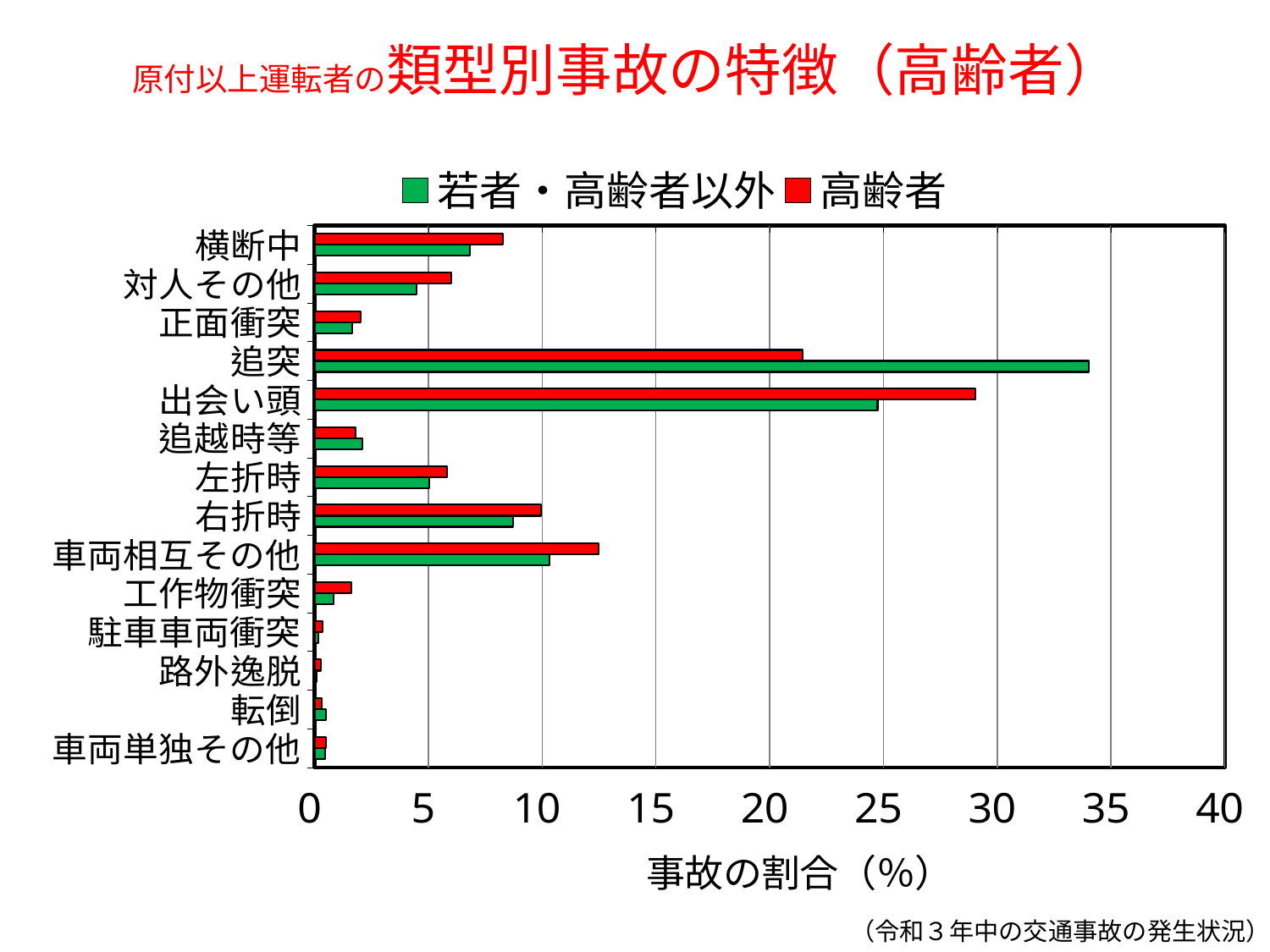
For 出会い頭, which series has the larger value, 若者・高齢者以外 or 高齢者? 高齢者 How many series does the legend list? 2 Which colour represents the 高齢者 series in the legend? red Is the 高齢者 value for 車両相互その他 greater or less than 10? greater What is the label of the x axis? 事故の割合（%） How many accident-type categories are plotted on the y axis? 14 Is the 高齢者 value for 追突 greater or less than 25? less For 追突, which series has the larger value, 若者・高齢者以外 or 高齢者? 若者・高齢者以外 Which category has the highest value for the 高齢者 series? 出会い頭 Is the 若者・高齢者以外 value for 追突 greater or less than 30? greater What kind of chart is shown on the slide? bar chart Which category has the highest value for the 若者・高齢者以外 series? 追突